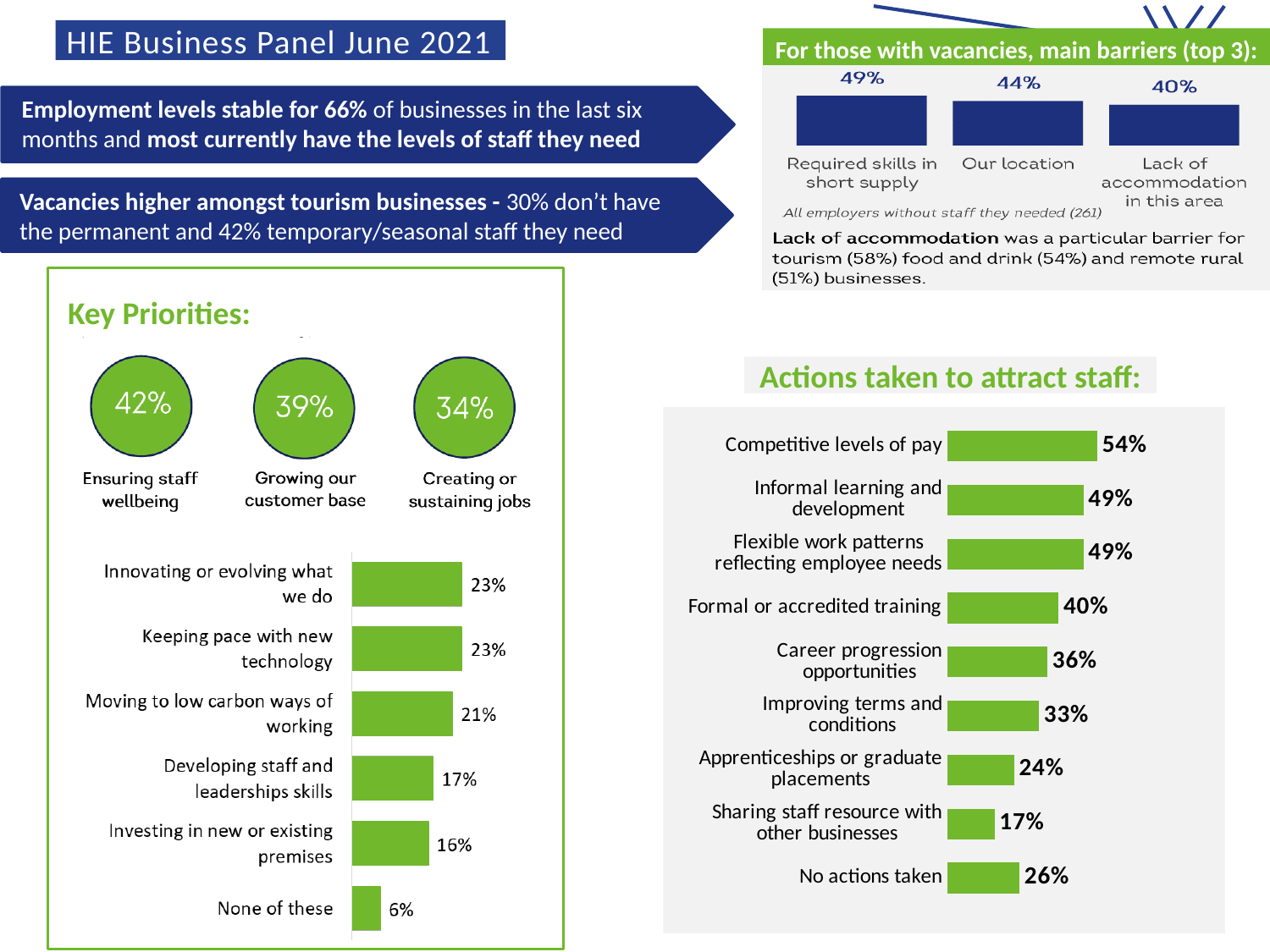
In the 'Actions taken to attract staff' chart, what is the value for No actions taken? 26% In the 'Key Priorities' bar chart, what is the value for Moving to low carbon ways of working? 21% In the 'For those with vacancies, main barriers (top 3)' chart, what is the difference between Required skills in short supply and Lack of accommodation in this area? 9% In the 'Actions taken to attract staff' chart, which action has the highest value? Competitive levels of pay In the 'Actions taken to attract staff' chart, what is the value for Competitive levels of pay? 54% In the 'Actions taken to attract staff' chart, what is the difference between Formal or accredited training and Career progression opportunities? 4% In the 'For those with vacancies, main barriers (top 3)' chart, what is the value for Our location? 44% In the 'Key Priorities' bar chart, which is larger: Developing staff and leaderships skills or Investing in new or existing premises? Developing staff and leaderships skills In the 'Actions taken to attract staff' chart, which category has the lowest value? Sharing staff resource with other businesses In the 'Actions taken to attract staff' chart, how many categories are shown? 9 What type of chart is the 'Actions taken to attract staff' chart? Bar chart In the 'Key Priorities' bar chart, which category has the lowest value? None of these